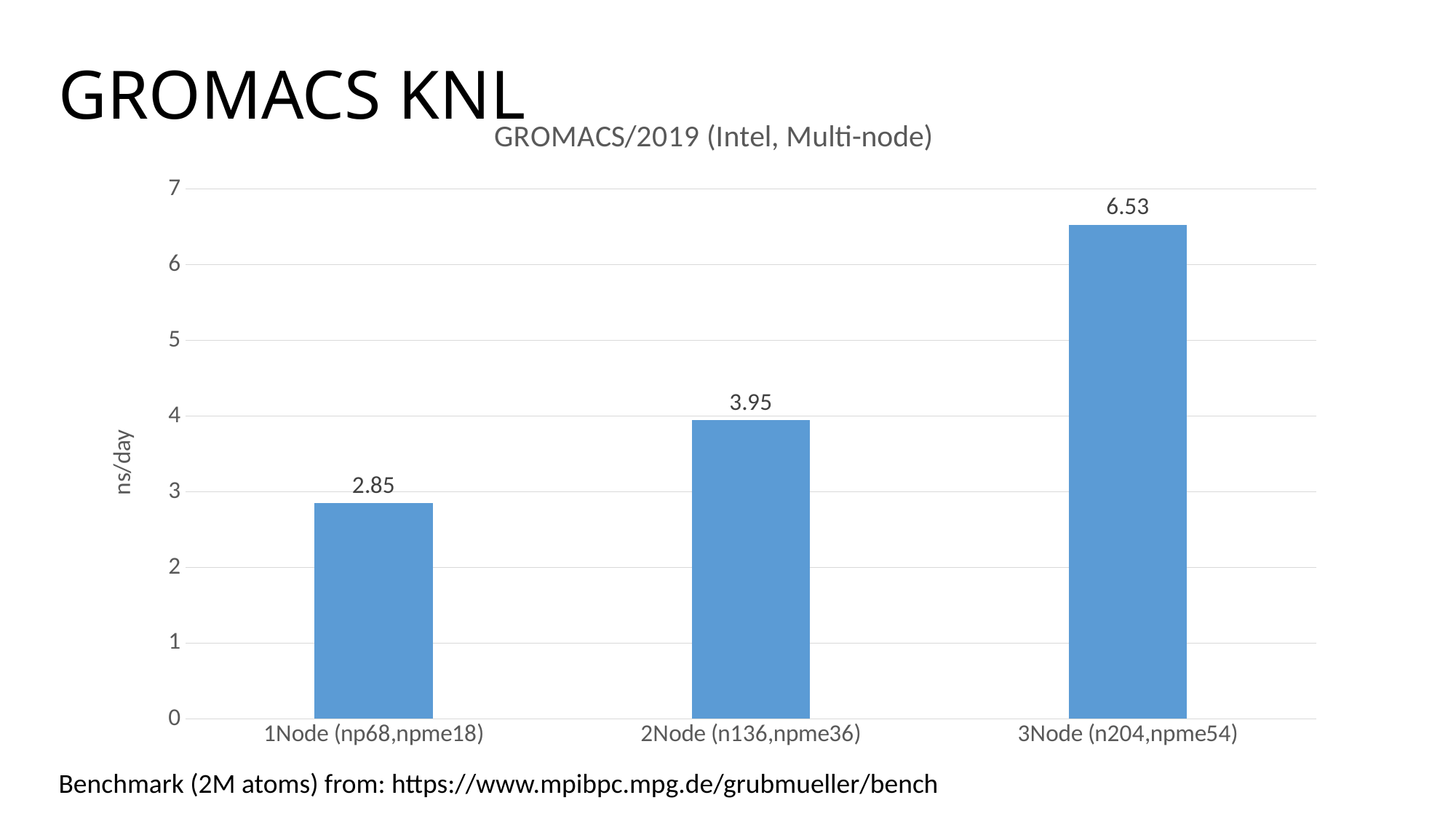
What is the ns/day value for 3Node (n204,npme54)? 6.53 What is the ns/day value for 1Node (np68,npme18)? 2.85 Which configuration has the highest ns/day? 3Node (n204,npme54) Which has a higher ns/day, 2Node (n136,npme36) or 3Node (n204,npme54)? 3Node (n204,npme54) How many configurations are plotted in the chart? 3 Do the ns/day values rise or fall as the number of nodes increases along the x axis? Rise What kind of chart is shown on the slide? Bar chart What is the ns/day value for 2Node (n136,npme36)? 3.95 What is the title of the chart? GROMACS/2019 (Intel, Multi-node) Which configuration has the lowest ns/day? 1Node (np68,npme18) What is the difference in ns/day between 3Node (n204,npme54) and 1Node (np68,npme18)? 3.68 What is the difference in ns/day between 2Node (n136,npme36) and 1Node (np68,npme18)? 1.10